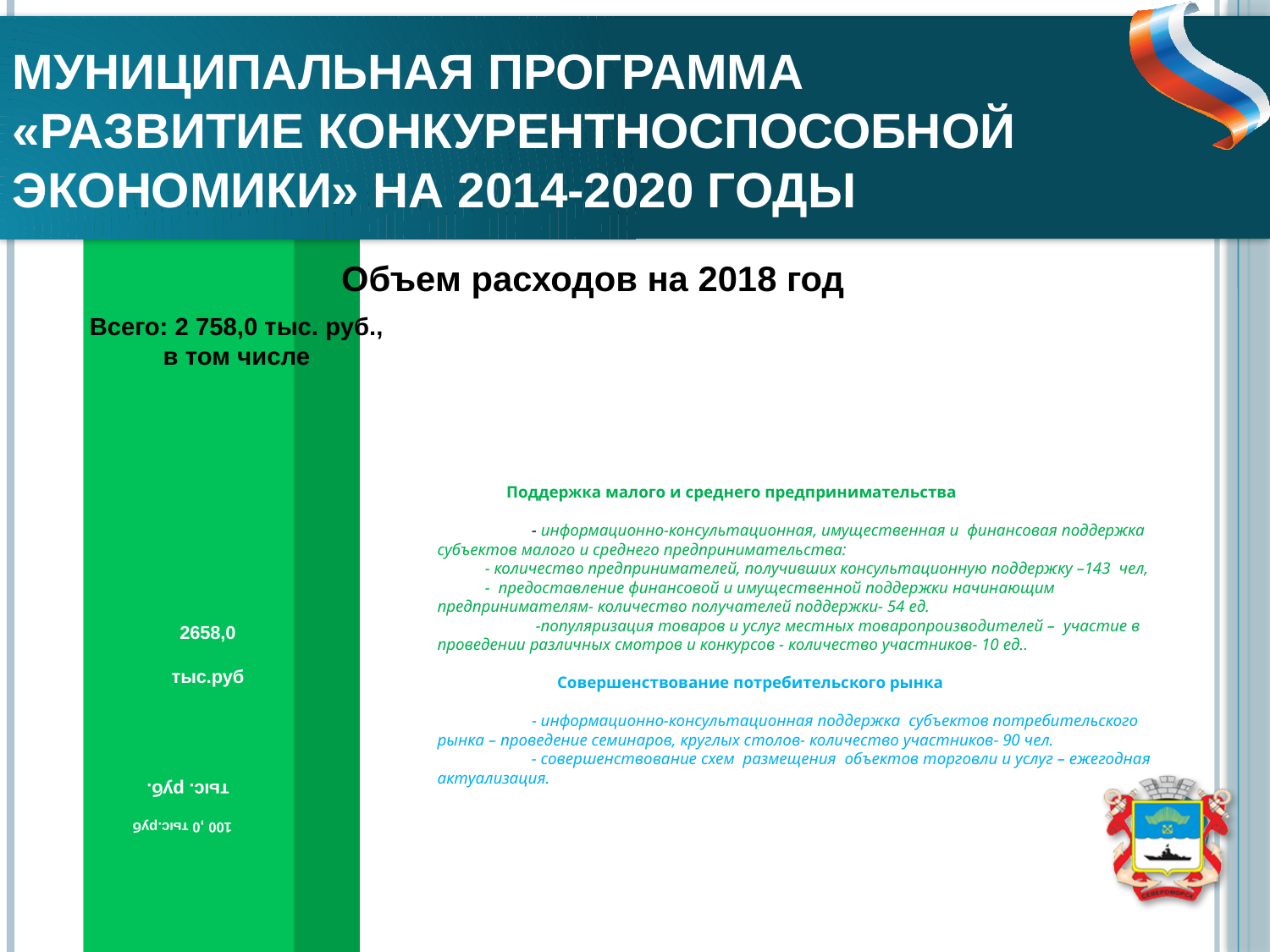
What is the difference between the two segment values shown on the bar, 2658,0 and 100,0? 2558,0 тыс.руб Is the value of the large segment of the bar greater or less than 2000 тыс.руб? greater What is the value printed on the large green segment of the bar? 2658,0 тыс.руб Which segment of the bar is larger, the one labelled 2658,0 or the one labelled 100,0? 2658,0 Is the value of the small segment of the bar greater or less than 500 тыс.руб? less How many segments make up the stacked bar? 2 What is the value printed on the small segment at the bottom of the bar (the rotated label)? 100,0 тыс.руб What is the title of the chart section on the slide? Объем расходов на 2018 год What total expenditure for 2018 is stated above the bar? 2 758,0 тыс. руб. What kind of chart is shown on the left of the slide? Stacked bar chart What colour is the bar on the slide? Green